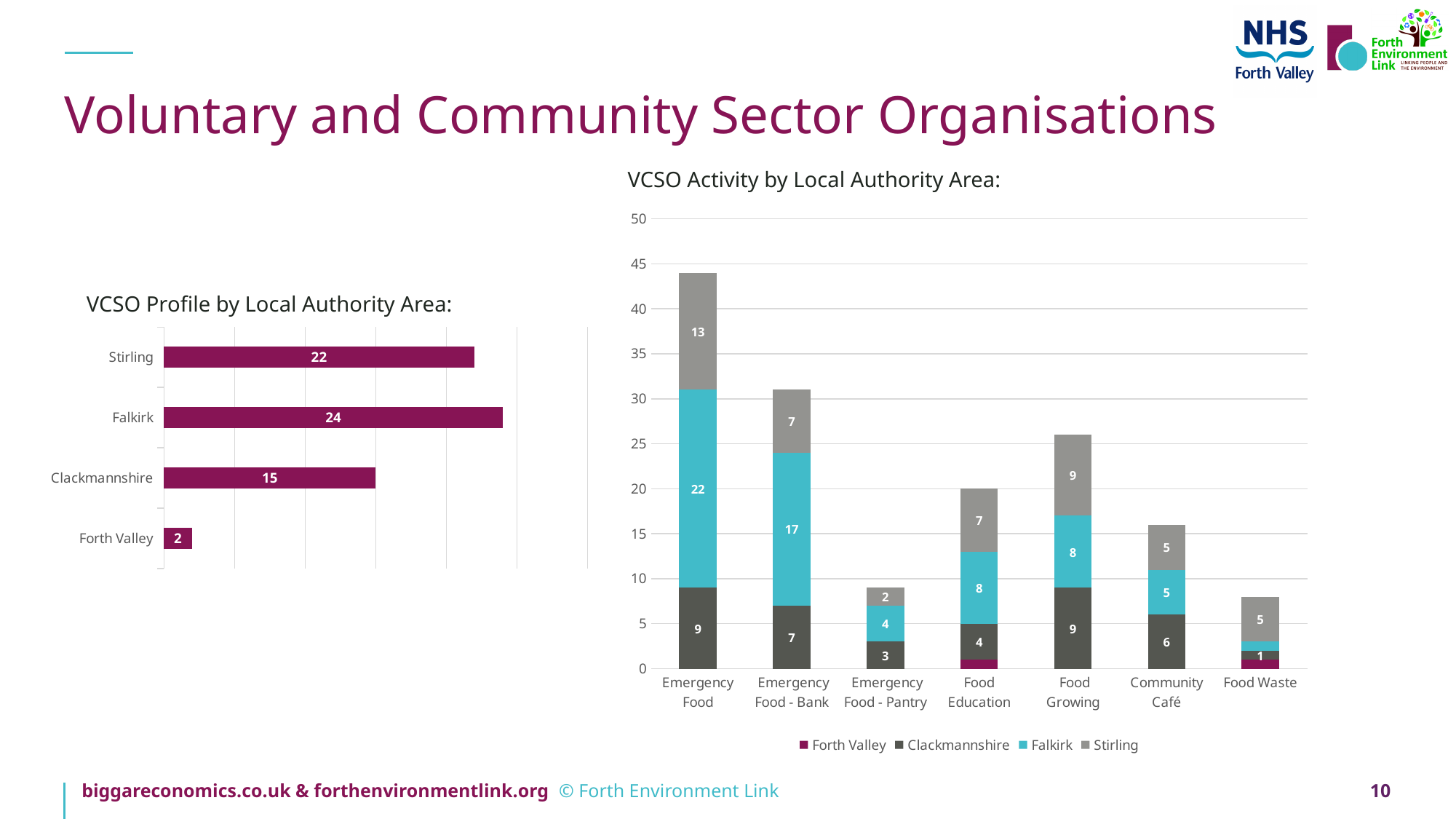
In the 'VCSO Activity by Local Authority Area' chart, which is larger: the Clackmannanshire value for Food Growing or the Clackmannanshire value for Food Education? Food Growing In the 'VCSO Profile by Local Authority Area' chart, which area has the lowest value? Forth Valley In the 'VCSO Profile by Local Authority Area' chart, what is the value for Falkirk? 24 In the 'VCSO Activity by Local Authority Area' chart, what is the total of the stacked bar for Emergency Food - Bank? 31 What kind of chart is 'VCSO Profile by Local Authority Area'? Bar chart In the 'VCSO Activity by Local Authority Area' chart, is the total bar for Community Café greater or less than 20? less In the 'VCSO Profile by Local Authority Area' chart, what is the difference between the values for Falkirk and Clackmannanshire? 9 In the 'VCSO Activity by Local Authority Area' chart, what is the Falkirk value for Emergency Food? 22 In the 'VCSO Activity by Local Authority Area' chart, which activity has the highest total bar? Emergency Food In the 'VCSO Activity by Local Authority Area' chart, how many series does the legend list? 4 In the 'VCSO Profile by Local Authority Area' chart, how many areas are shown? 4 In the 'VCSO Activity by Local Authority Area' chart, what is the Stirling value for Food Growing? 9